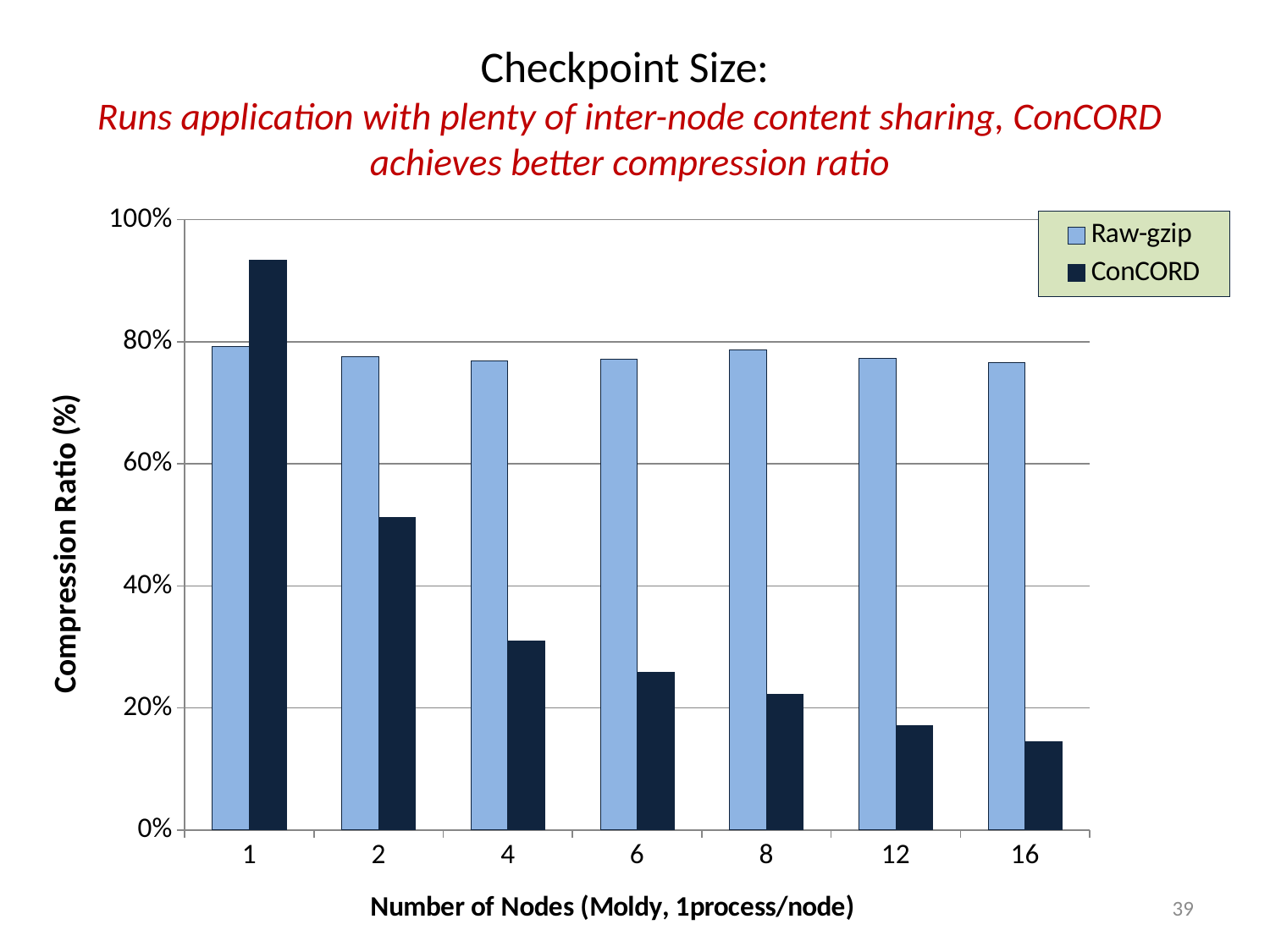
Does the ConCORD compression ratio rise or fall as the number of nodes increases? fall How many series does the legend list? 2 What kind of chart is shown on the slide? bar chart At 8 nodes, which series has the higher compression ratio, Raw-gzip or ConCORD? Raw-gzip Is the ConCORD value for 4 nodes greater or less than 40%? less Is the ConCORD value for 16 nodes greater or less than 20%? less Is the ConCORD value for 1 node greater or less than 80%? greater For which number of nodes is the ConCORD compression ratio lowest? 16 For which number of nodes is the ConCORD compression ratio highest? 1 How many node-count categories are shown on the x axis? 7 At 1 node, which series has the higher compression ratio, Raw-gzip or ConCORD? ConCORD